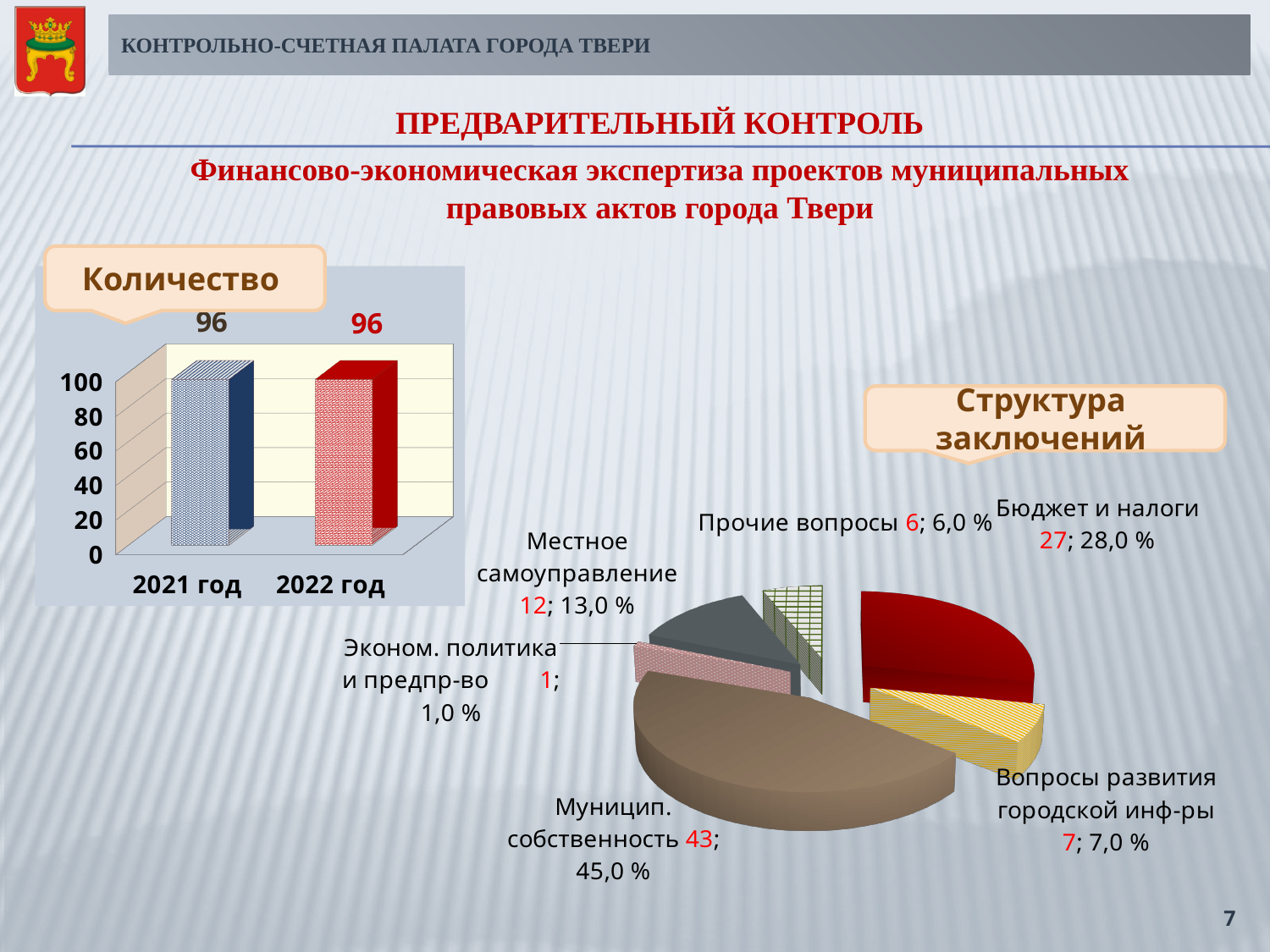
In the "Структура заключений" pie chart, which category has the largest slice? Муницип. собственность In the "Структура заключений" pie chart, which category has the smallest slice? Эконом. политика и предпр-во In the "Структура заключений" pie chart, how many slices are there? 6 In the "Структура заключений" pie chart, what share does Муницип. собственность have? 45,0 % What kind of chart is the "Структура заключений" chart? pie chart What kind of chart is the "Количество" chart? bar chart In the "Количество" bar chart, what is the difference between the values for 2021 год and 2022 год? 0 In the "Количество" bar chart, what is the value for 2022 год? 96 In the "Количество" bar chart, what is the value for 2021 год? 96 In the "Структура заключений" pie chart, which is larger: Местное самоуправление or Прочие вопросы? Местное самоуправление In the "Количество" bar chart, how many categories are shown on the x axis? 2 In the "Структура заключений" pie chart, what is the value for Бюджет и налоги? 27